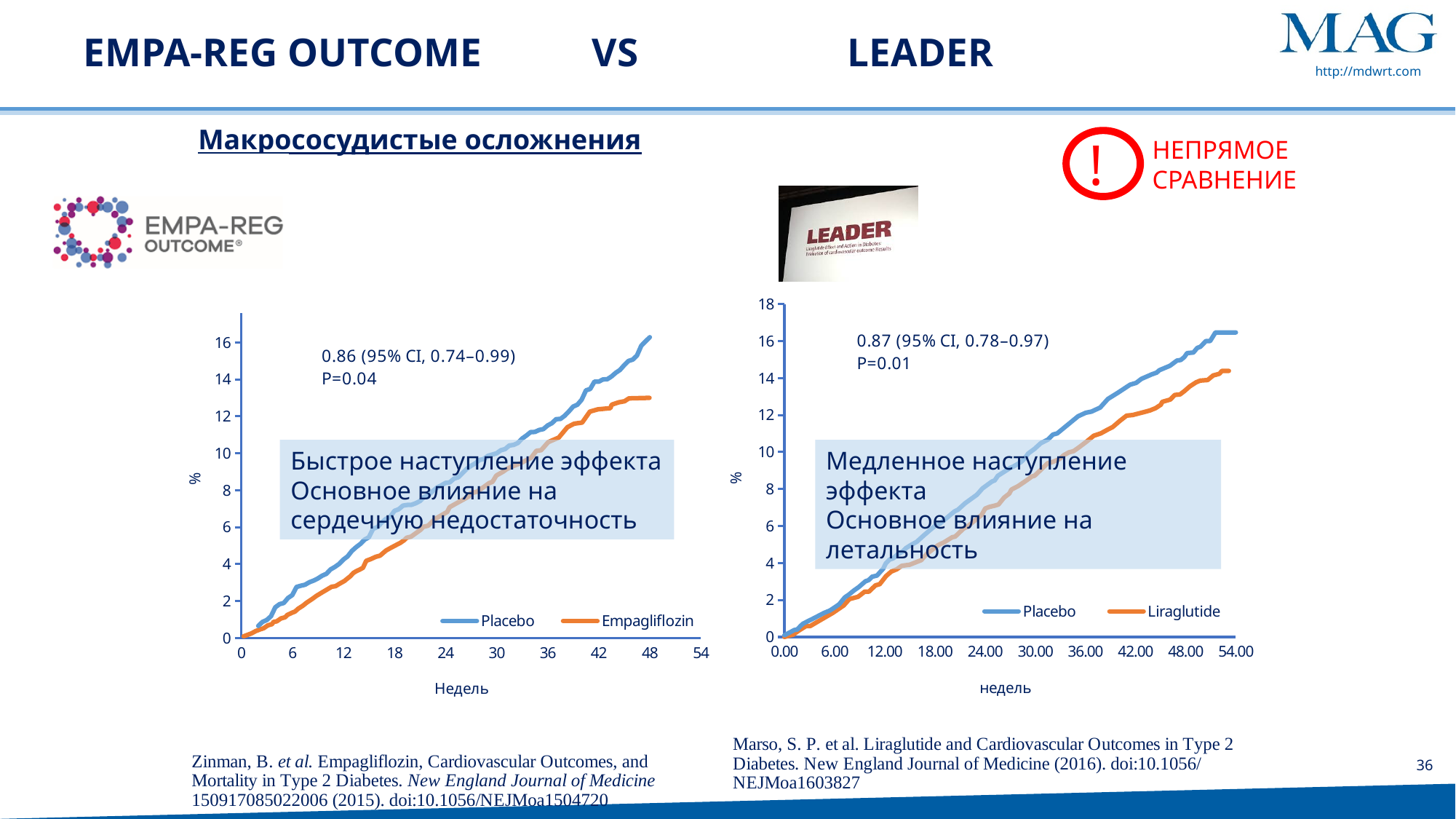
How many series does the legend of the LEADER chart on the right list? 2 In the LEADER chart on the right, which series is shown in orange? Liraglutide In the LEADER chart on the right, do the Liraglutide values rise or fall along the x axis? rise In the EMPA-REG OUTCOME chart on the left, which two series are listed in the legend? Placebo and Empagliflozin In the EMPA-REG OUTCOME chart on the left, is the Placebo value at week 48 greater or less than 14? greater In the LEADER chart on the right, is the Placebo value at week 54 greater or less than 14? greater What kind of chart is the EMPA-REG OUTCOME chart on the left? line chart In the EMPA-REG OUTCOME chart on the left, which series is higher at week 48, Placebo or Empagliflozin? Placebo In the LEADER chart on the right, is the Liraglutide value at week 54 greater or less than 12? greater In the EMPA-REG OUTCOME chart on the left, do the Placebo values rise or fall as the weeks increase? rise In the LEADER chart on the right, which series is higher at the end of the curves, Placebo or Liraglutide? Placebo